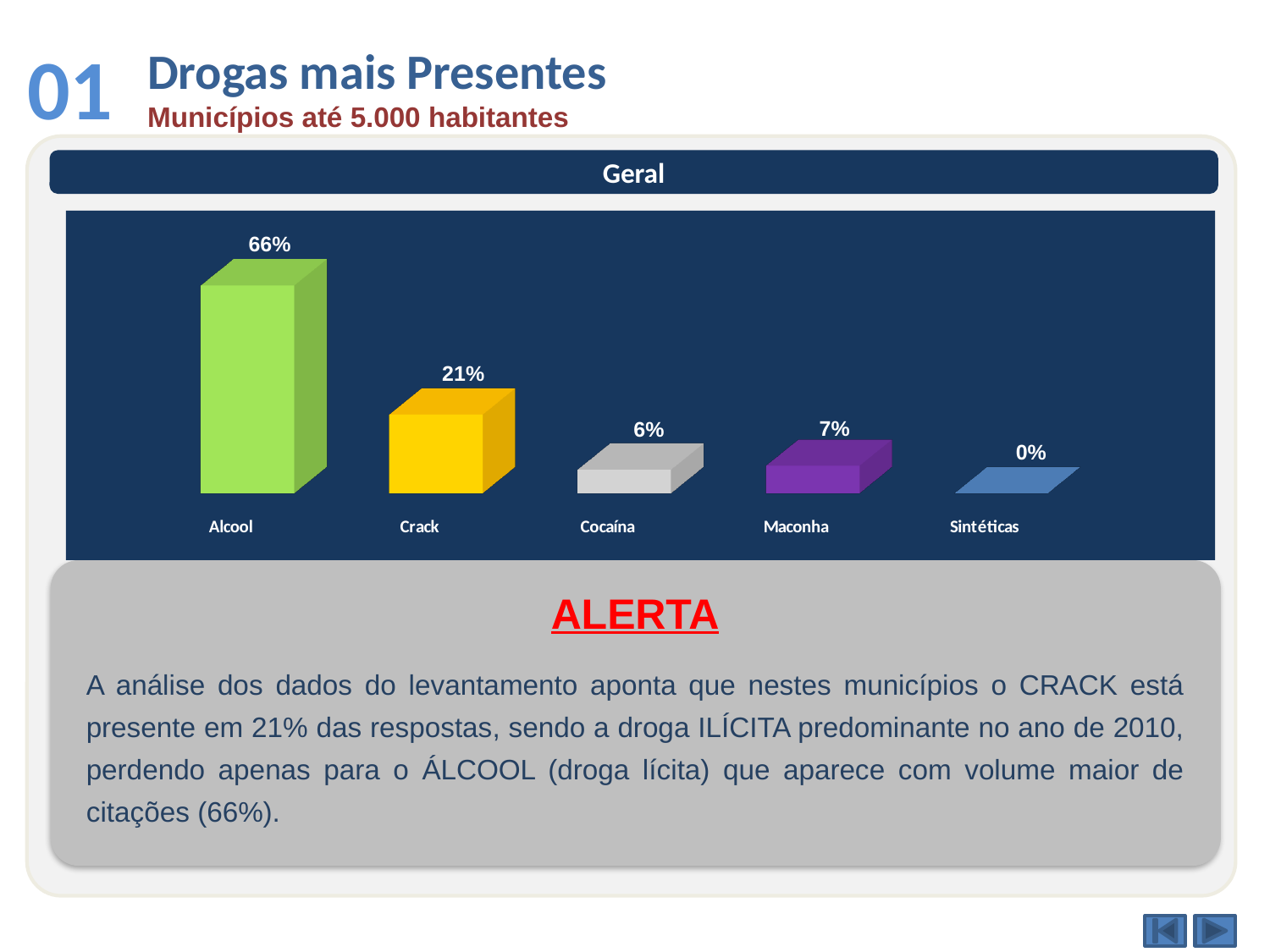
Which is larger, the value for Maconha or the value for Cocaína? Maconha What is the value for Sintéticas? 0% What is the value for Crack? 21% How many categories are shown in the chart? 5 What is the value for Alcool? 66% What is the difference between the values for Alcool and Crack? 45% What is the title shown in the header bar above the chart? Geral Which category has the highest value? Alcool What kind of chart is shown on the slide? Bar chart Which category has the lowest value? Sintéticas What is the value for Cocaína? 6% What is the value for Maconha? 7%